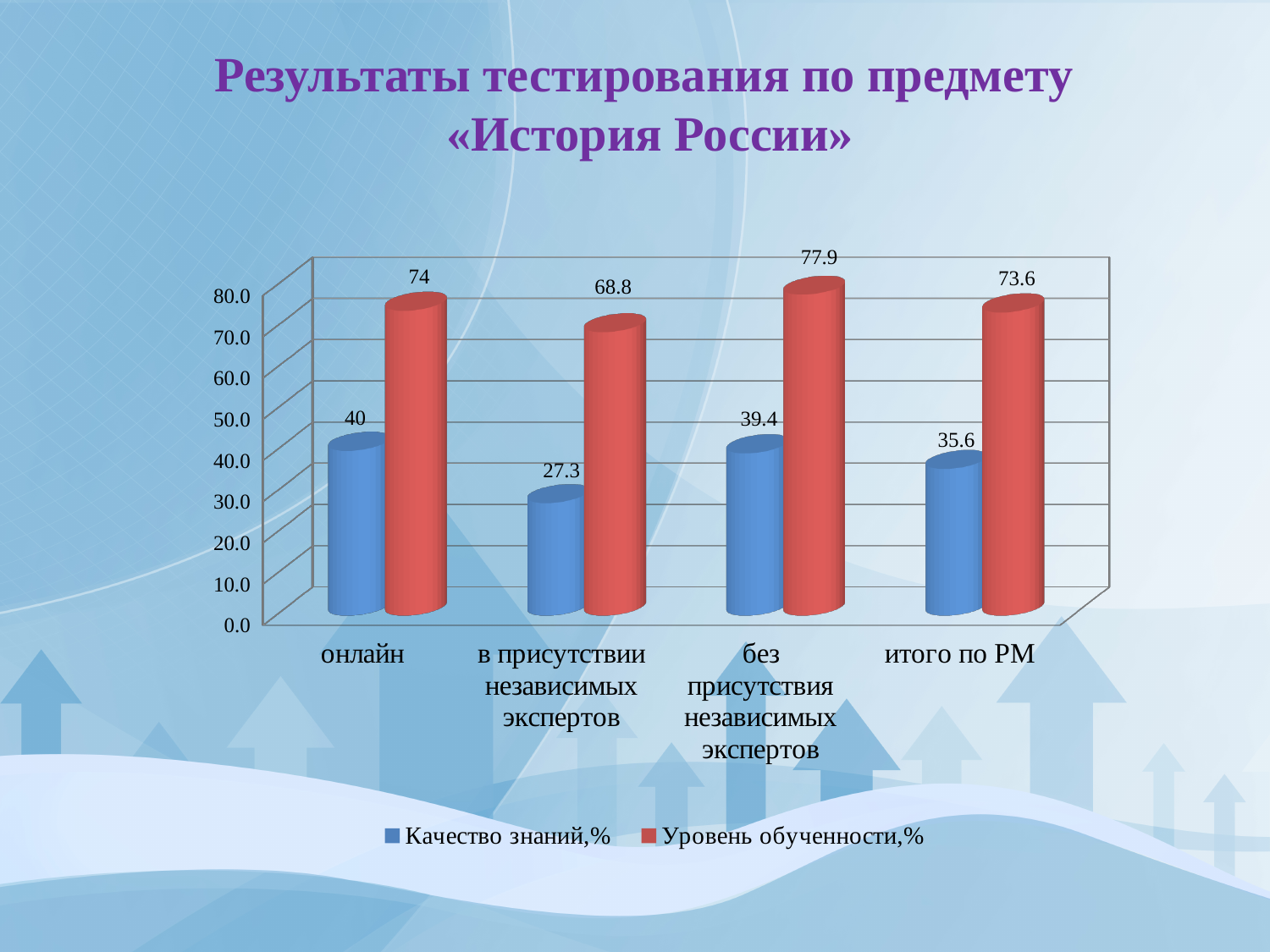
Which category has the highest value of Уровень обученности,%? без присутствия независимых экспертов Which is larger: Качество знаний,% for онлайн or for без присутствия независимых экспертов? онлайн What is the value of Качество знаний,% for онлайн? 40 What is the value of Уровень обученности,% for в присутствии независимых экспертов? 68.8 How many series does the legend list? 2 What kind of chart is shown on the slide? bar chart What is the value of Качество знаний,% for итого по РМ? 35.6 What is the difference between Уровень обученности,% and Качество знаний,% for онлайн? 34 Is the value of Уровень обученности,% for итого по РМ greater or less than 70.0? greater How many categories are shown on the x axis? 4 What is the value of Уровень обученности,% for без присутствия независимых экспертов? 77.9 Which category has the lowest value of Качество знаний,%? в присутствии независимых экспертов